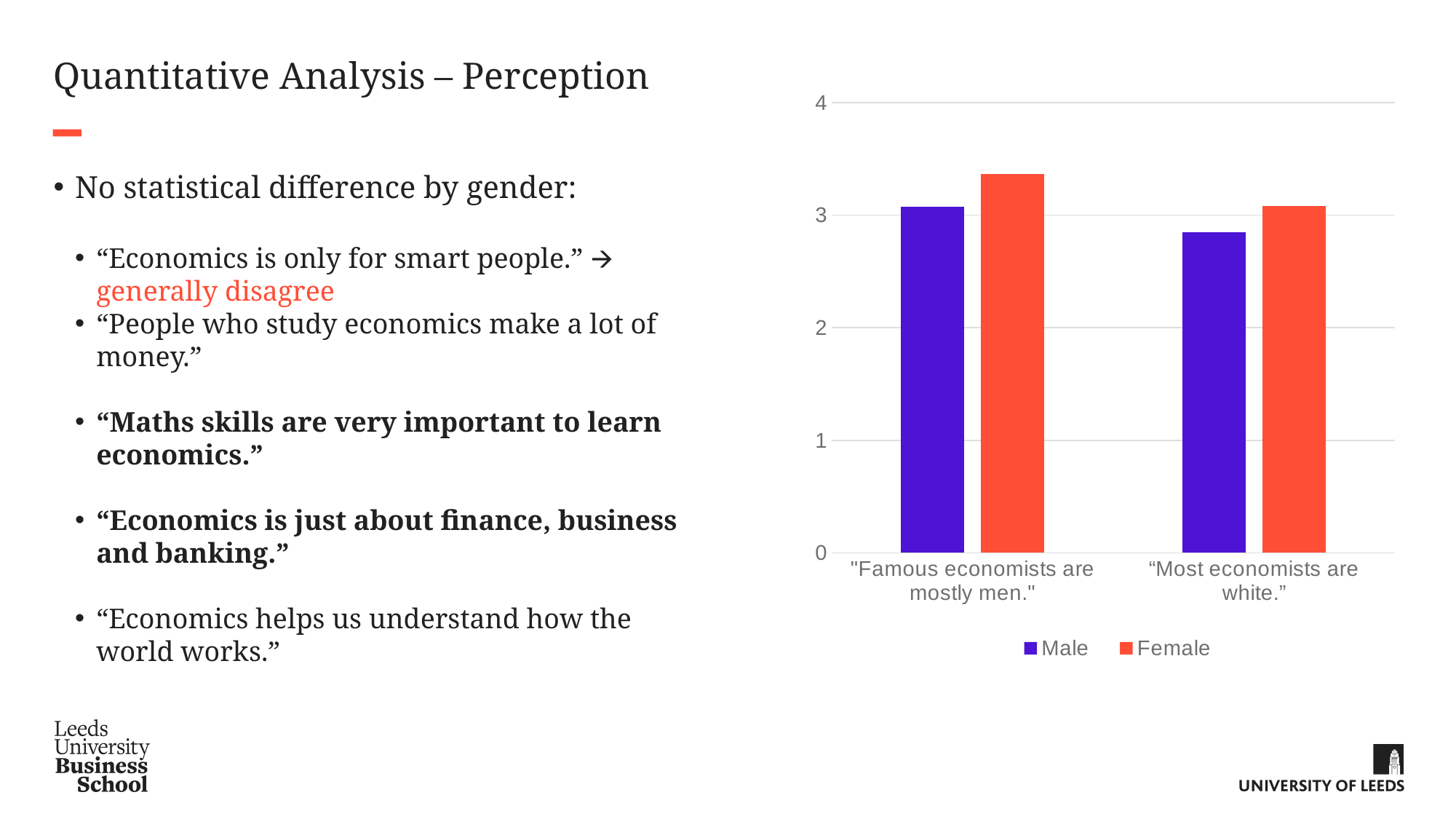
How many categories are shown on the x axis of the chart? 2 Which bar is the shortest in the chart? Male for "Most economists are white." Is the Male value for "Most economists are white." greater or less than 3? less Is the Male value for "Famous economists are mostly men." greater or less than 2? greater What colour represents the Female series in the chart? orange-red What is the highest value shown on the chart's vertical axis? 4 What kind of chart is shown on the slide? bar chart Which series has the higher value for "Famous economists are mostly men.", Male or Female? Female Which bar is the tallest in the chart? Female for "Famous economists are mostly men." How many series does the chart's legend list? 2 Which series has the higher value for "Most economists are white.", Male or Female? Female Is the Female value for "Famous economists are mostly men." greater or less than 3? greater